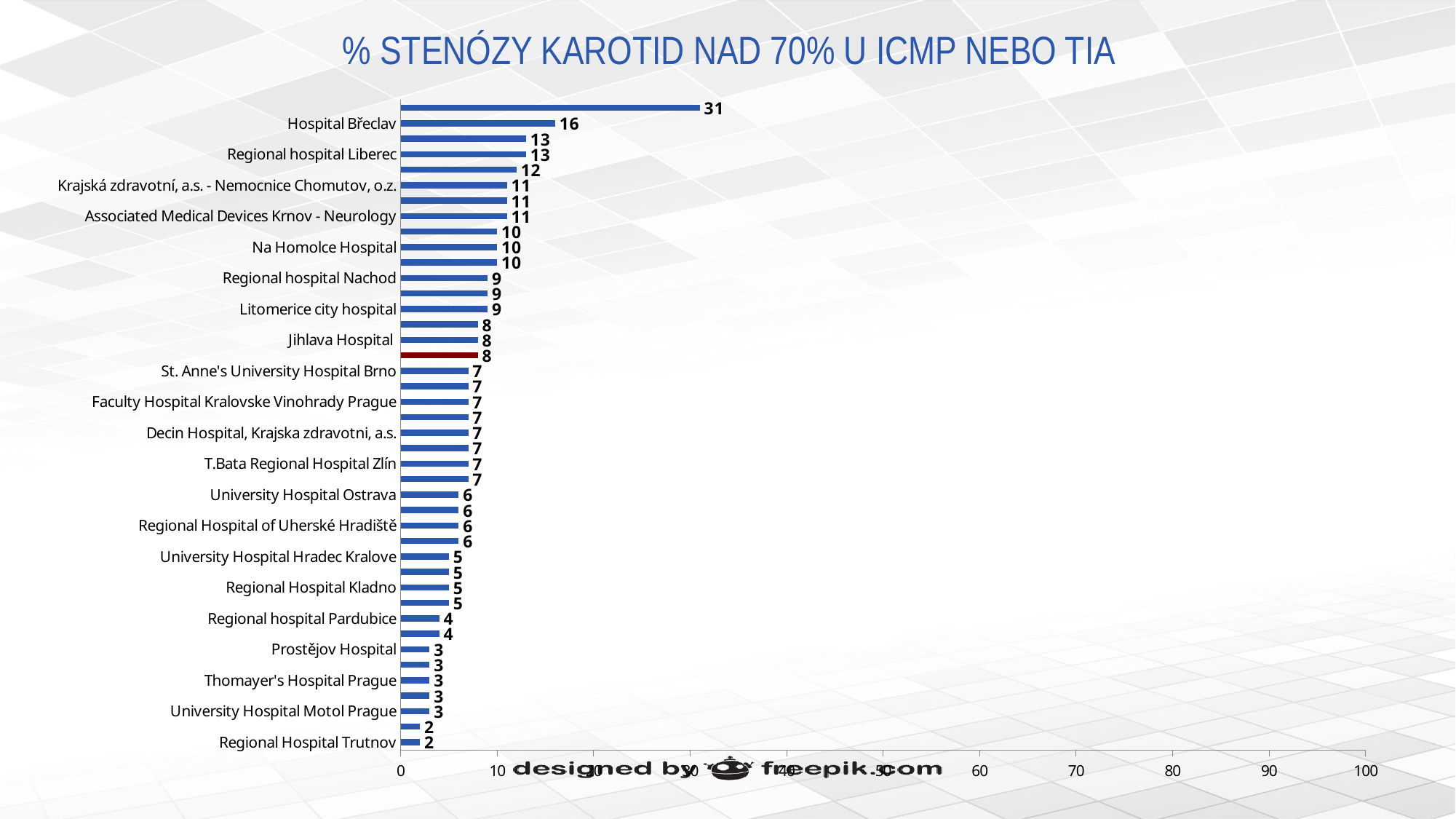
What is the value for Regional hospital Liberec? 13 What is the difference between the values for Hospital Břeclav and Regional hospital Liberec? 3 What is the title of the chart? % STENÓZY KAROTID NAD 70% U ICMP NEBO TIA Which has a larger value, Jihlava Hospital or University Hospital Ostrava? Jihlava Hospital What is the value for Na Homolce Hospital? 10 Is the value for Hospital Břeclav greater or less than 10? greater What kind of chart is shown on the slide? bar chart How many bars are plotted in the chart? 42 What is the value for University Hospital Motol Prague? 3 What is the value of the bar highlighted in dark red? 8 What is the value for Regional Hospital Trutnov? 2 What is the value for Hospital Břeclav? 16